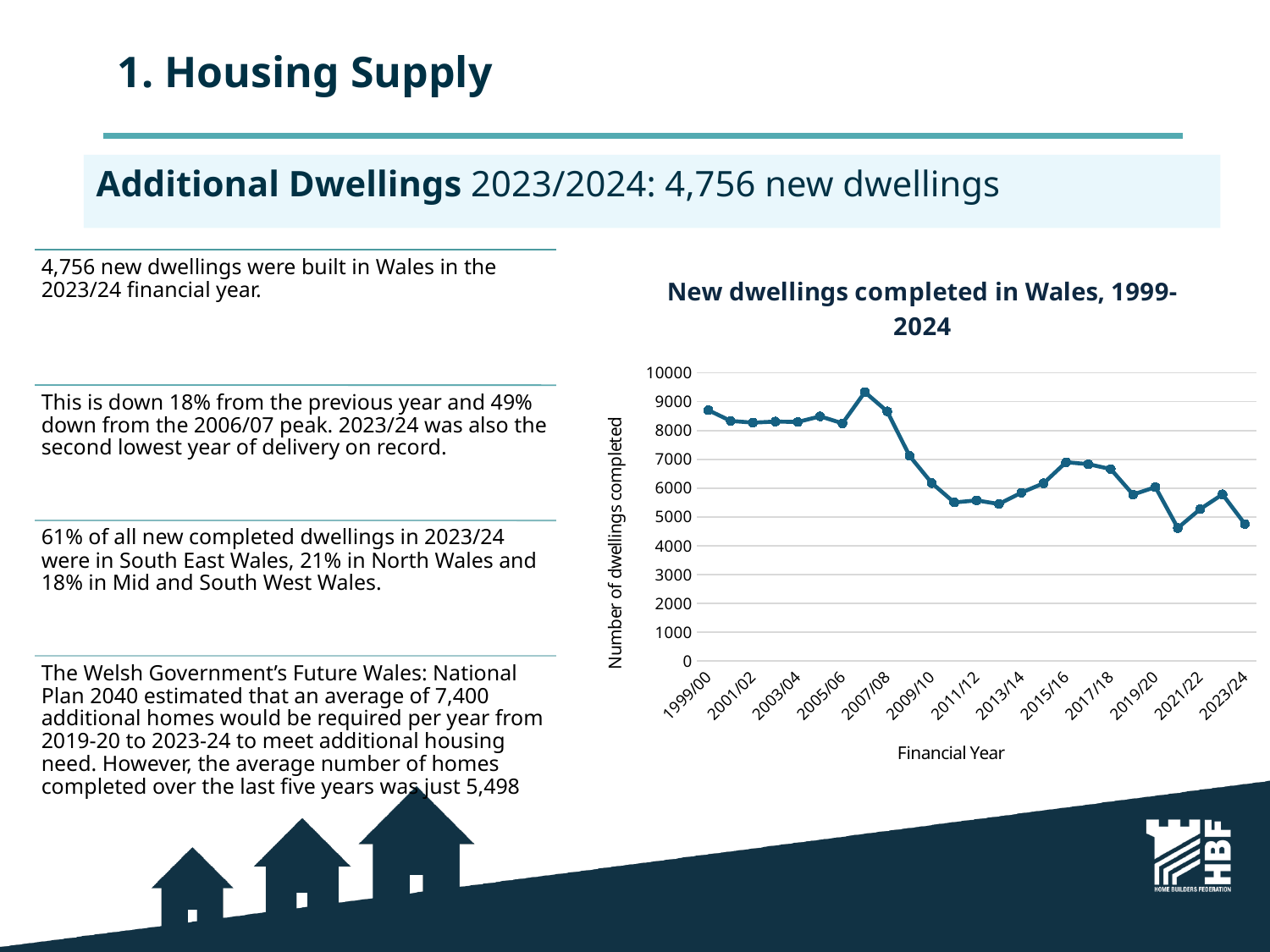
Overall, do the values rise or fall from 1999/00 to 2023/24? fall Is the value for 1999/00 greater or less than 8000? greater Is the value for 2003/04 greater or less than 8000? greater How many data points are plotted on the line in the chart? 25 Is the value for 2011/12 greater or less than 6000? less What is the title of the chart? New dwellings completed in Wales, 1999-2024 What is the label on the vertical axis of the chart? Number of dwellings completed Which is larger, the value for 1999/00 or the value for 2023/24? 1999/00 What kind of chart is shown on the slide? line chart